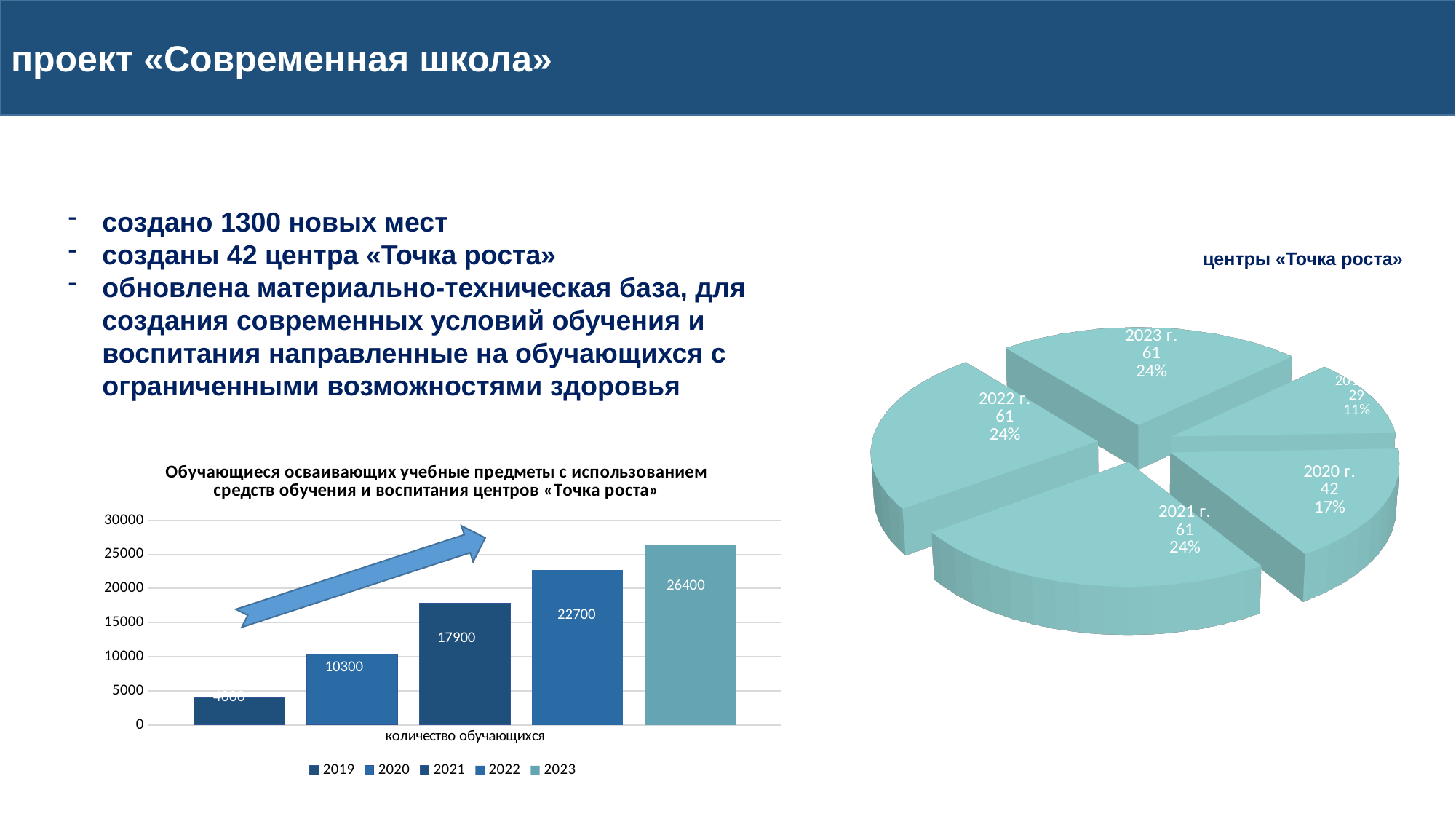
How many series does the legend of the bar chart on the left list? 5 In the bar chart on the left, do the values rise or fall from 2019 to 2023? rise In the bar chart on the left, which is larger: the value for 2020 or the value for 2021? 2021 What kind of chart is the chart on the left of the slide? bar chart In the bar chart on the left, is the value for 2019 greater or less than 5000? less In the pie chart «центры «Точка роста»», what is the value for 2020 г.? 42 In the bar chart on the left, what is the difference between the values for 2023 and 2022? 3700 In the bar chart on the left, what is the value for 2021? 17900 In the bar chart on the left, what is the value for 2023? 26400 In the bar chart on the left, which year has the highest value? 2023 In the pie chart «центры «Точка роста»», what share does 2021 г. have? 24% In the bar chart on the left, which year has the lowest value? 2019